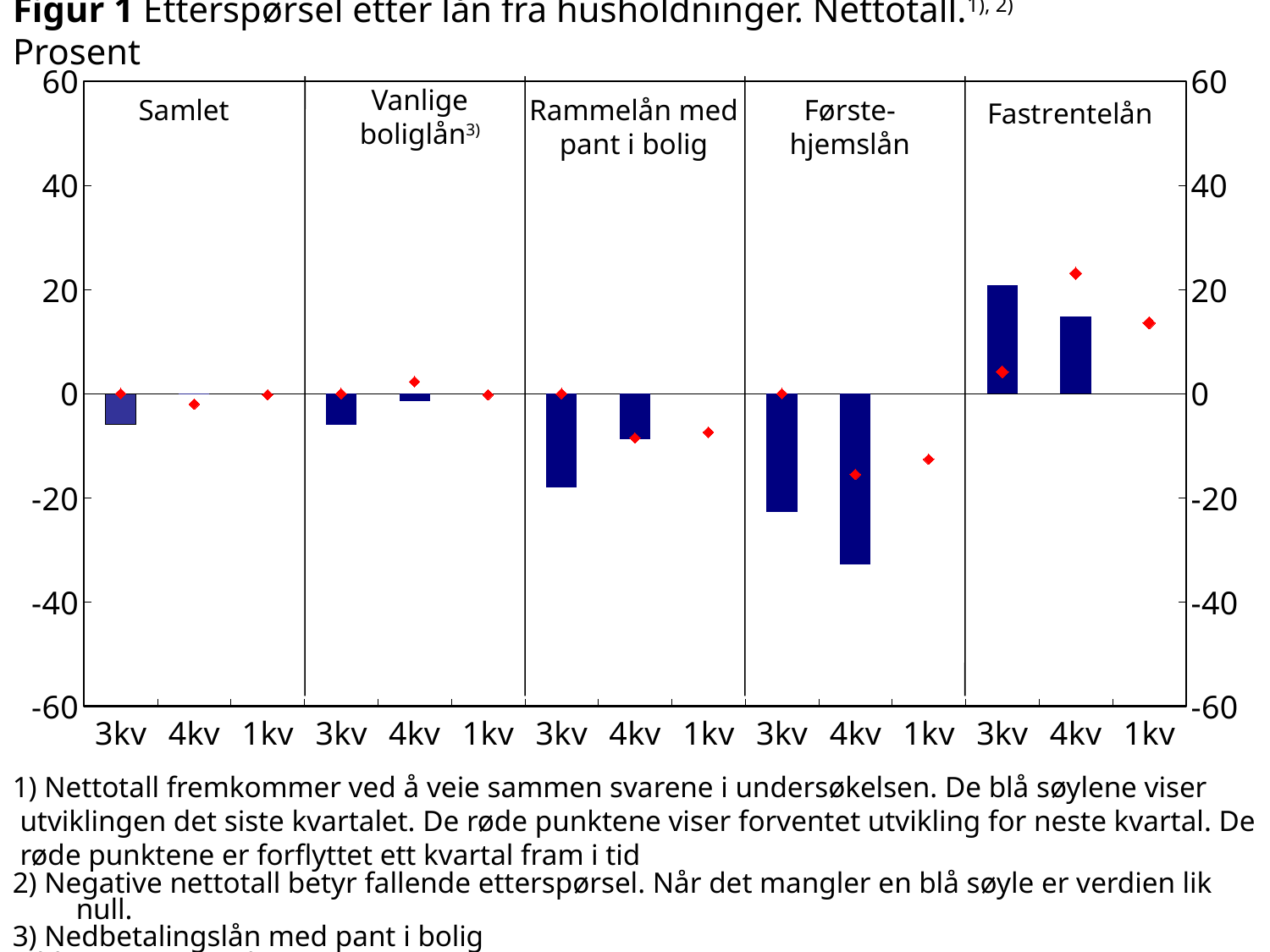
In the Rammelån med pant i bolig panel, which quarter has the larger blue bar value, 3kv or 4kv? 4kv Which panel and quarter has the lowest blue bar in the chart? Førstehjemslån, 4kv Is the blue bar for Fastrentelån in 3kv greater or less than 10? greater Which panel is the only one with positive blue bars? Fastrentelån In the Fastrentelån panel, which quarter has the larger blue bar value, 3kv or 4kv? 3kv Is the blue bar for Rammelån med pant i bolig in 3kv greater or less than -10? less According to the footnote, what do the red points in the chart show? Forventet utvikling for neste kvartal Is the blue bar for Førstehjemslån in 4kv greater or less than -20? less Which panel and quarter has the highest blue bar in the chart? Fastrentelån, 3kv How many loan categories (panels) are shown in the chart? 5 How many quarters are shown on the x axis within each panel? 3 What kind of chart is shown in Figur 1? Bar chart with point markers